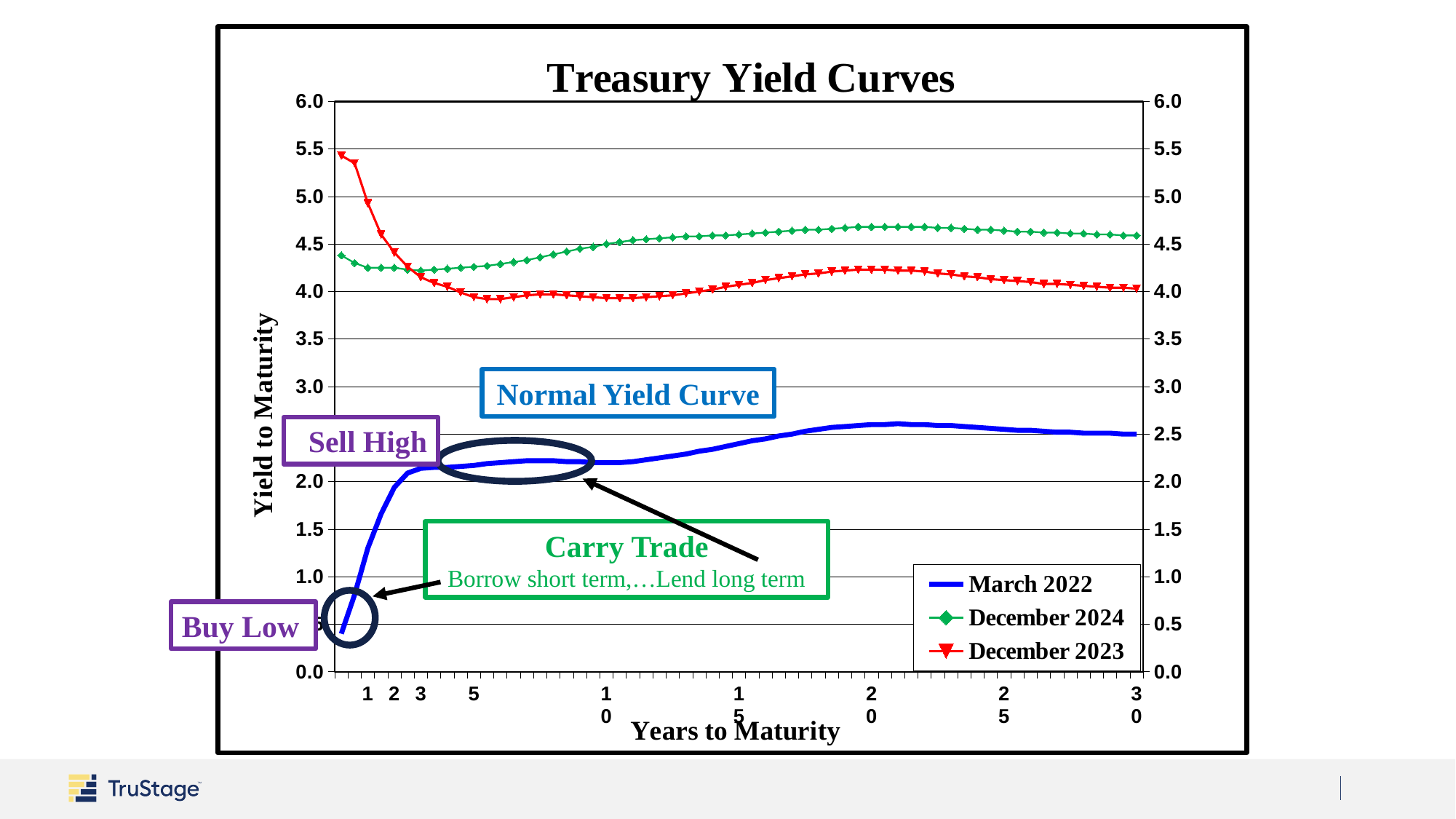
Is the March 2022 value at 30 years to maturity greater or less than 3.0? less What is the title of the chart? Treasury Yield Curves What kind of chart is shown on the slide? line chart Does the December 2023 curve rise or fall between the shortest maturity and 5 years? fall How many series does the legend list? 3 What is the label of the vertical axis? Yield to Maturity Does the March 2022 curve rise or fall between the shortest maturity and 5 years? rise Is the December 2023 value at 30 years to maturity greater or less than 4.5? less At 30 years to maturity, which series is higher: December 2024 or December 2023? December 2024 Is the December 2024 value at 30 years to maturity greater or less than 4.0? greater At 1 year to maturity, which series is higher: December 2023 or December 2024? December 2023